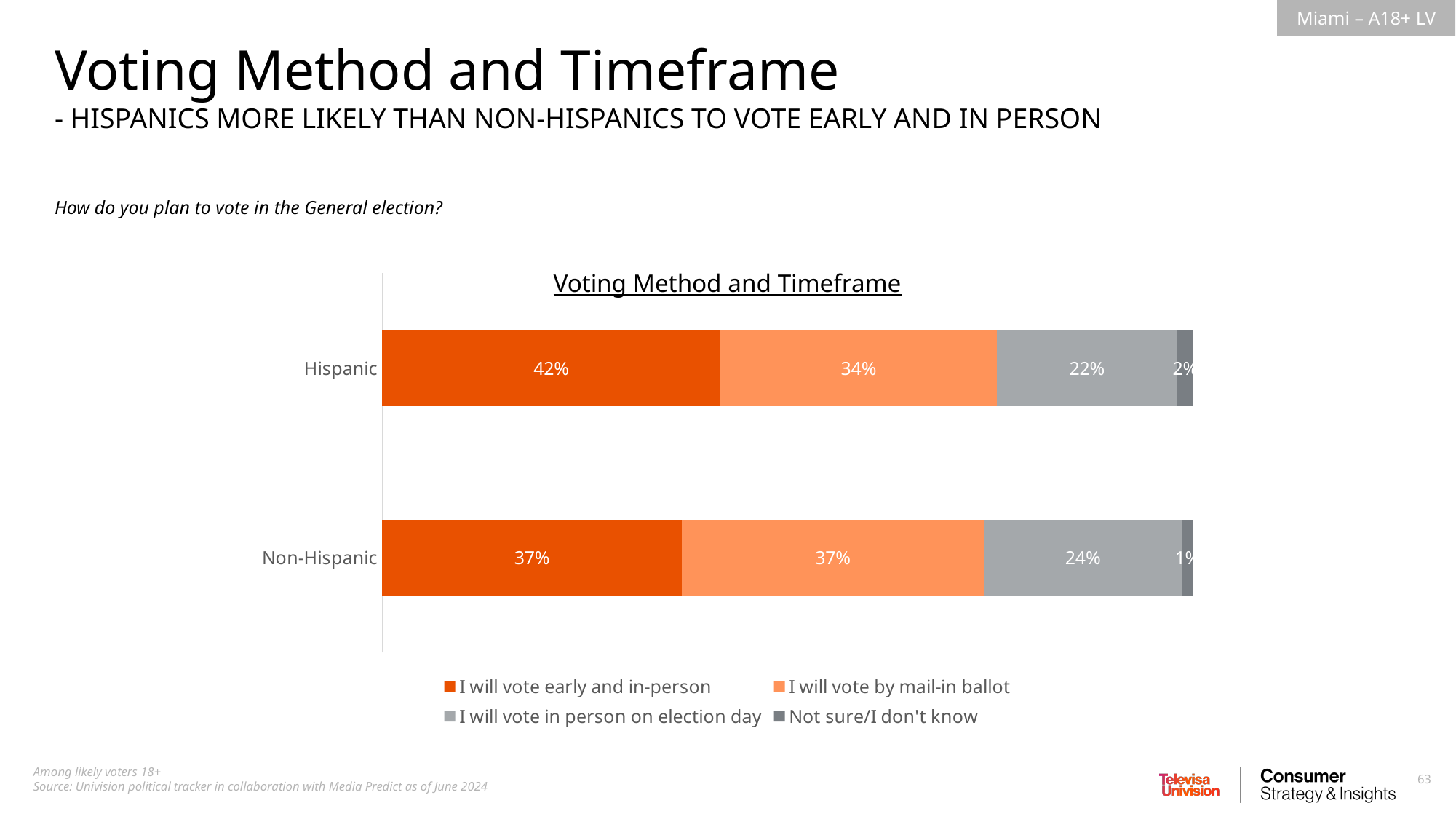
What percentage of Non-Hispanic respondents are not sure / don't know how they will vote? 1% What kind of chart is shown on the slide? Stacked bar chart How many groups (categories) are shown on the chart? 2 Which voting method has the largest share among Hispanic respondents? I will vote early and in-person What percentage of Hispanic respondents say they will vote early and in-person? 42% Which group has the higher share saying they will vote early and in-person, Hispanic or Non-Hispanic? Hispanic What percentage of Non-Hispanic respondents say they will vote by mail-in ballot? 37% What is the difference in percentage points between Non-Hispanic and Hispanic respondents who will vote by mail-in ballot? 3 percentage points What is the difference in percentage points between Hispanic and Non-Hispanic respondents who will vote early and in-person? 5 percentage points Which response has the smallest share among Non-Hispanic respondents? Not sure/I don't know How many series does the legend list? 4 What percentage of Hispanic respondents say they will vote in person on election day? 22%